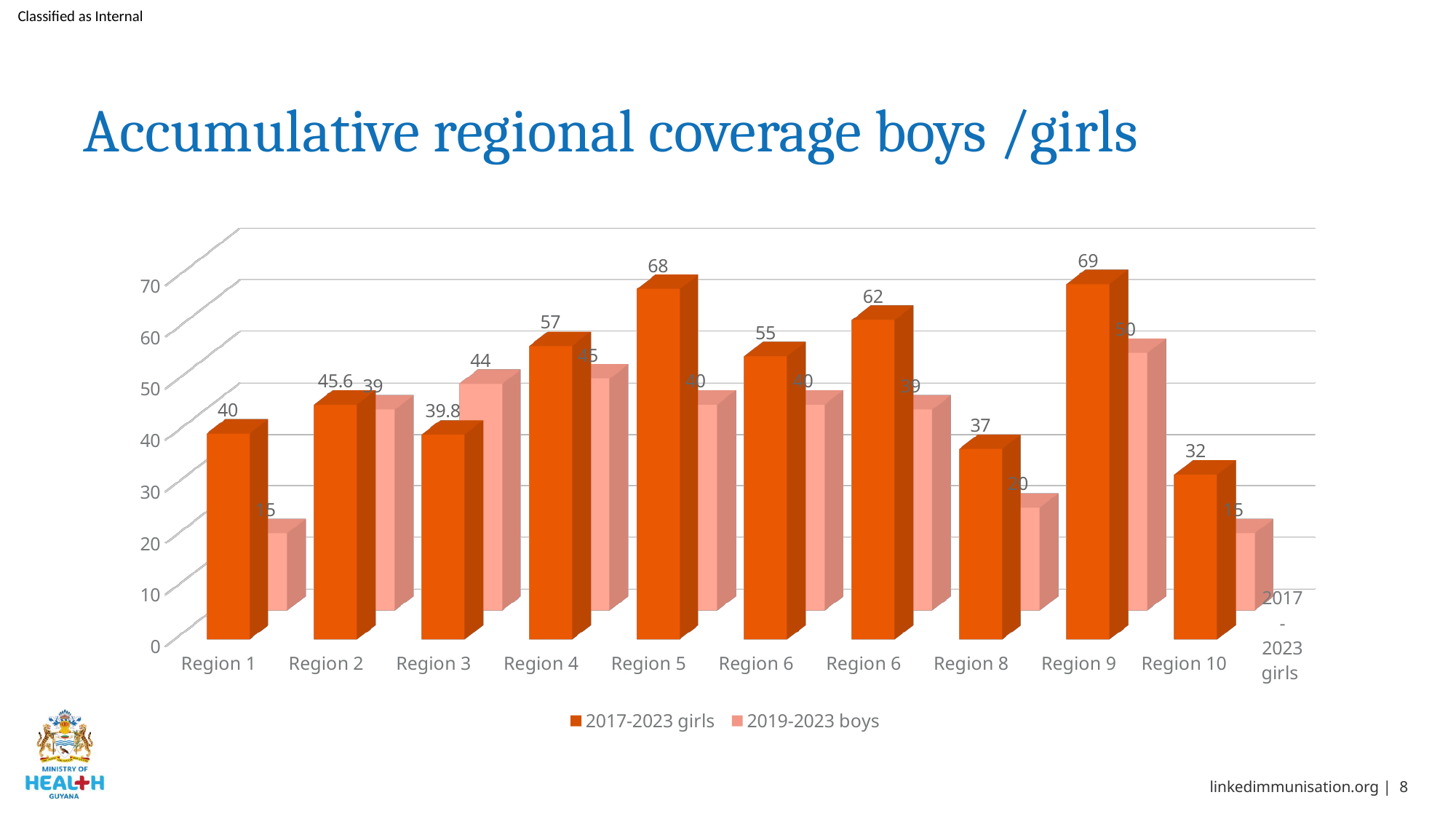
Which region has the highest 2017-2023 girls value? Region 9 Which region has the lowest 2017-2023 girls value? Region 10 What is the title of the chart? Accumulative regional coverage boys /girls How many series does the legend list? 2 Which region has the highest 2019-2023 boys value? Region 9 What type of chart is shown on the slide? Bar chart What is the difference between the girls and boys values for Region 9? 19 For Region 3, which is larger: the 2017-2023 girls value or the 2019-2023 boys value? 2019-2023 boys What is the 2017-2023 girls value for Region 2? 45.6 What is the difference between the girls and boys values for Region 1? 25 What is the 2019-2023 boys value for Region 8? 20 What is the 2017-2023 girls value for Region 3? 39.8